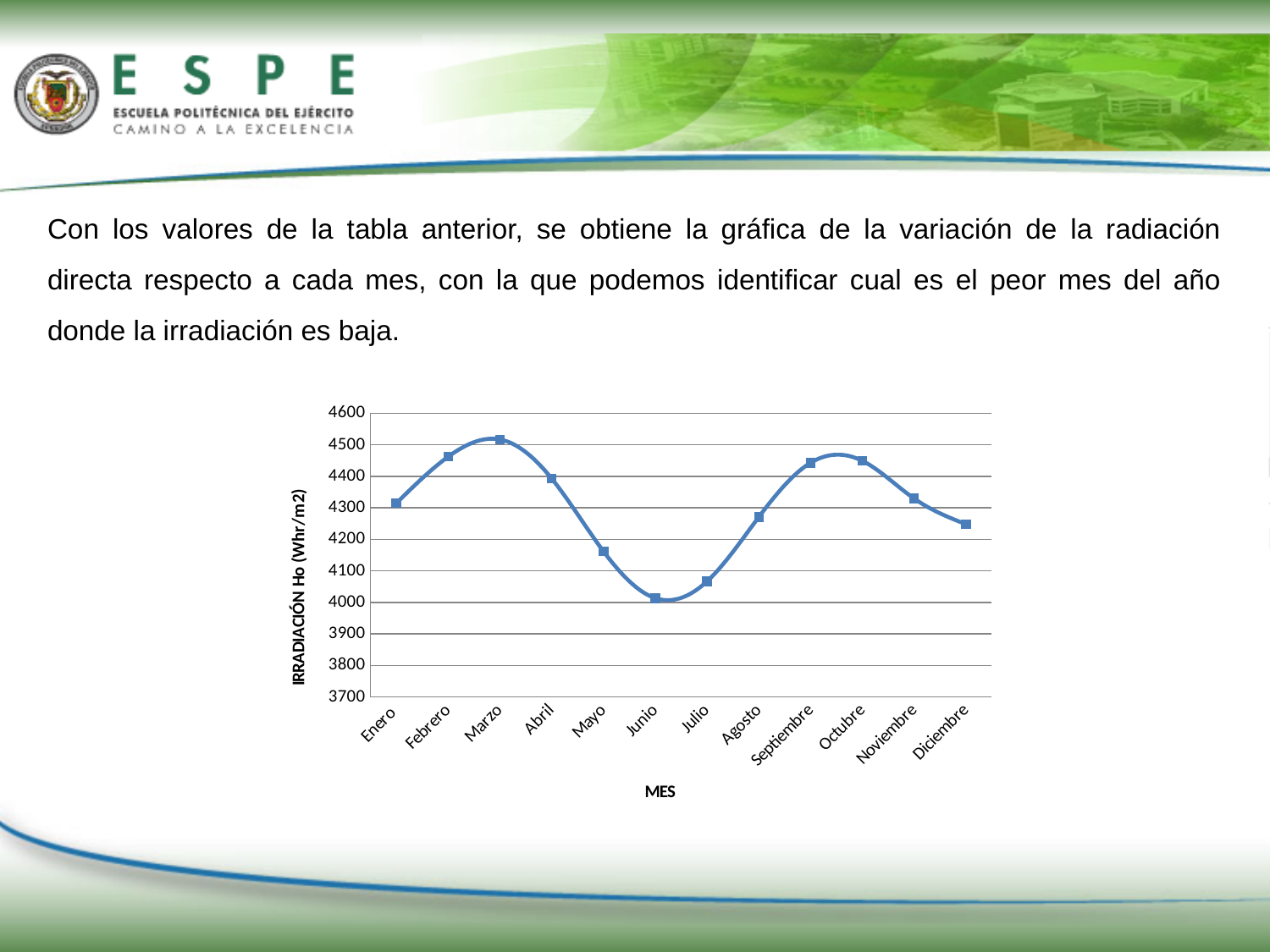
Is the value for Septiembre greater or less than 4400? greater Is the value for Junio greater or less than 4100? less Which month has the lowest irradiation value in the chart? Junio Which month has a higher irradiation value, Febrero or Mayo? Febrero Is the value for Mayo greater or less than 4200? less Do the values rise or fall from Marzo to Junio? fall How many months are plotted on the x axis of the chart? 12 What kind of chart is shown on the slide? line chart Which month has the highest irradiation value in the chart? Marzo What is the title of the vertical axis of the chart? IRRADIACIÓN Ho (Whr/m2)